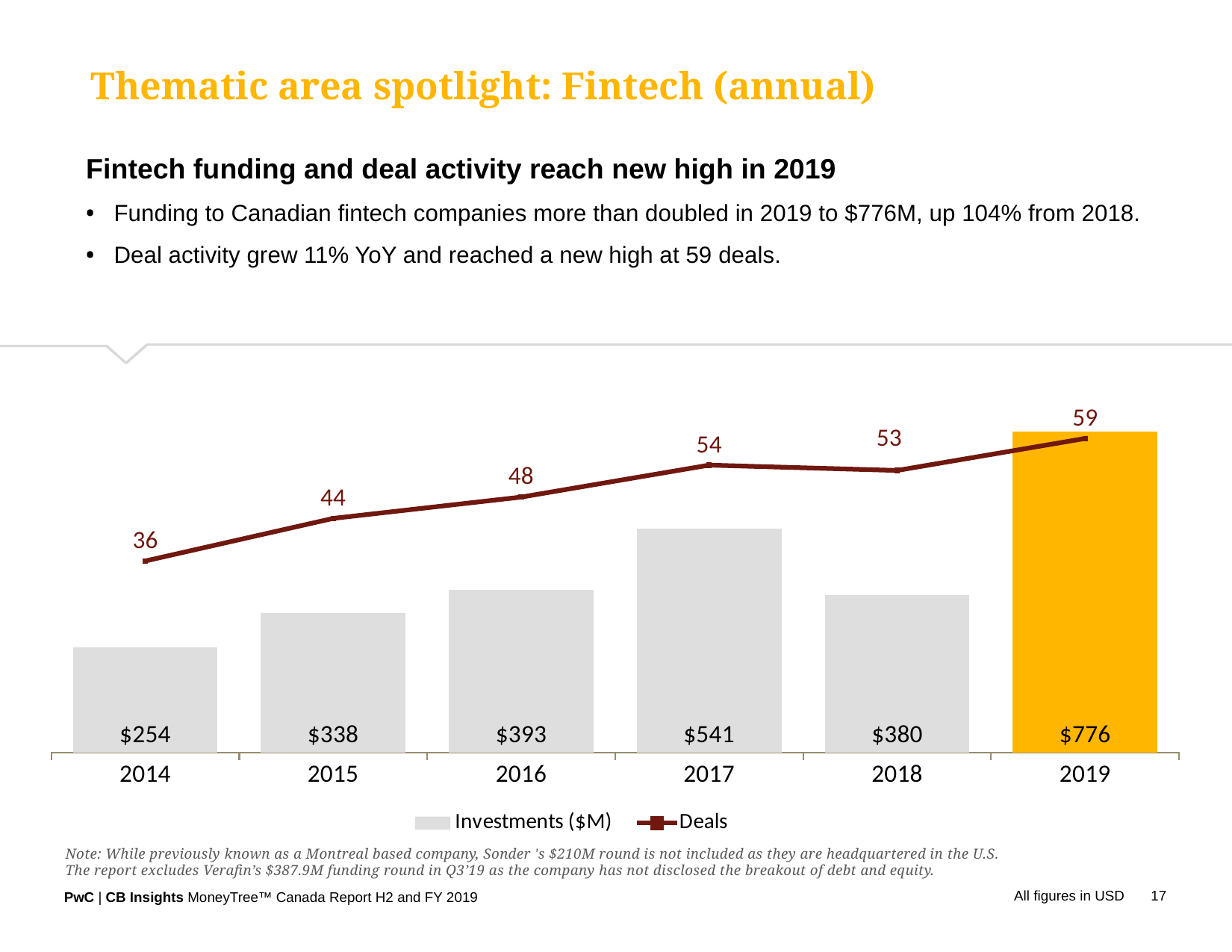
How many Deals were there in 2015? 44 Which year had the lowest number of Deals? 2014 What kind of chart is used to show Investments ($M)? Bar chart What is the difference in Investments ($M) between 2019 and 2018? $396 Which year had higher Investments ($M), 2016 or 2018? 2016 Which year had more Deals, 2017 or 2018? 2017 Which bar in the chart is highlighted in a different colour (orange) from the others? 2019 How many years are shown on the x axis of the chart? 6 How many series does the chart legend list? 2 What was the value of Investments ($M) in 2017? $541 How many more Deals were there in 2019 than in 2014? 23 Which year had the highest Investments ($M)? 2019